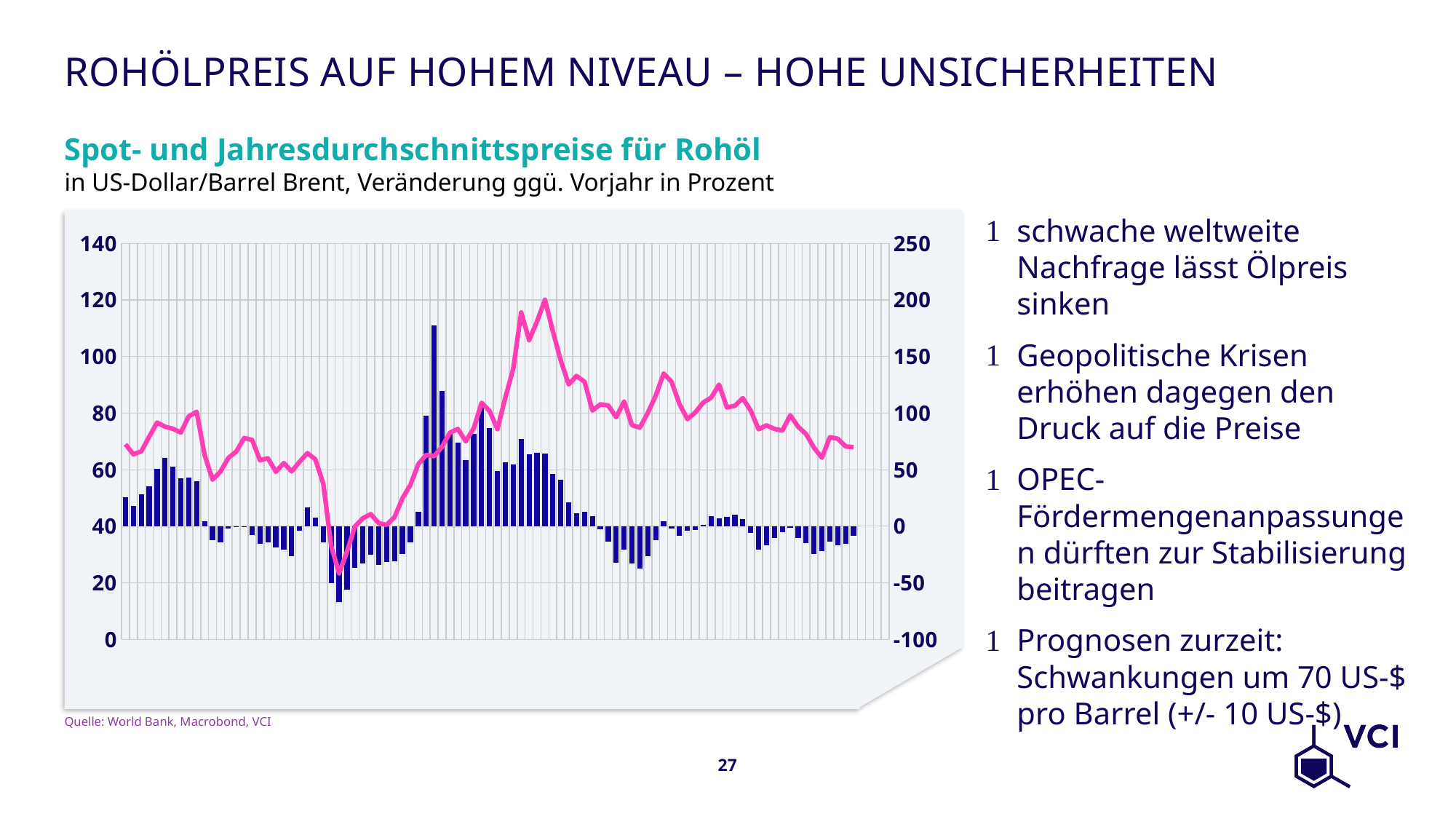
How many data series are plotted in the chart? 2 Is the lowest point of the pink line greater or less than 40 on the left axis? less Over the final stretch of the chart, does the pink line generally rise or fall? fall Is the lowest blue bar greater or less than -50 on the right axis? less Is the highest point of the pink line greater or less than 100 on the left axis? greater What is the maximum value shown on the right axis of the chart? 250 What kind of chart is shown on the slide? a combined bar and line chart What is the title of the chart? Spot- und Jahresdurchschnittspreise für Rohöl